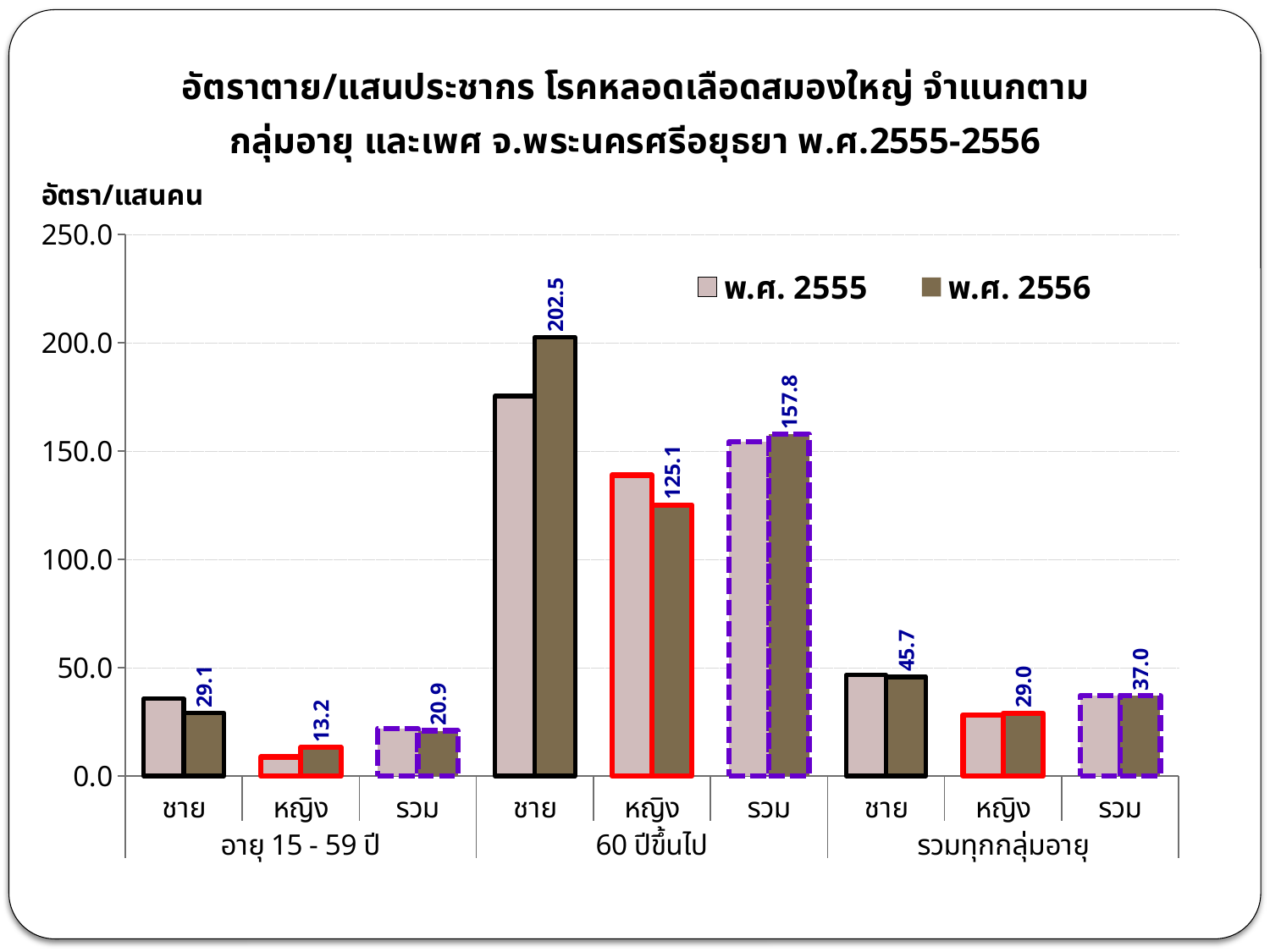
For พ.ศ. 2556, which is larger: รวม in the 60 ปีขึ้นไป group or รวม in the รวมทุกกลุ่มอายุ group? รวม in the 60 ปีขึ้นไป group Is the พ.ศ. 2555 value for ชาย in the 60 ปีขึ้นไป group greater or less than 150.0? greater Is the พ.ศ. 2555 value for หญิง in the 60 ปีขึ้นไป group greater or less than 150.0? less How many categories are shown on the x axis? 9 What is the value for พ.ศ. 2556 for ชาย in the อายุ 15 - 59 ปี group? 29.1 What kind of chart is shown on the slide? bar chart What is the value for พ.ศ. 2556 for หญิง in the 60 ปีขึ้นไป group? 125.1 How many series does the legend list? 2 Which bar has the highest value for พ.ศ. 2556? ชาย, 60 ปีขึ้นไป What is the difference between the พ.ศ. 2556 values for ชาย and หญิง in the 60 ปีขึ้นไป group? 77.4 What is the value for พ.ศ. 2556 for รวม in the รวมทุกกลุ่มอายุ group? 37.0 Which bar has the lowest value for พ.ศ. 2556? หญิง, อายุ 15 - 59 ปี